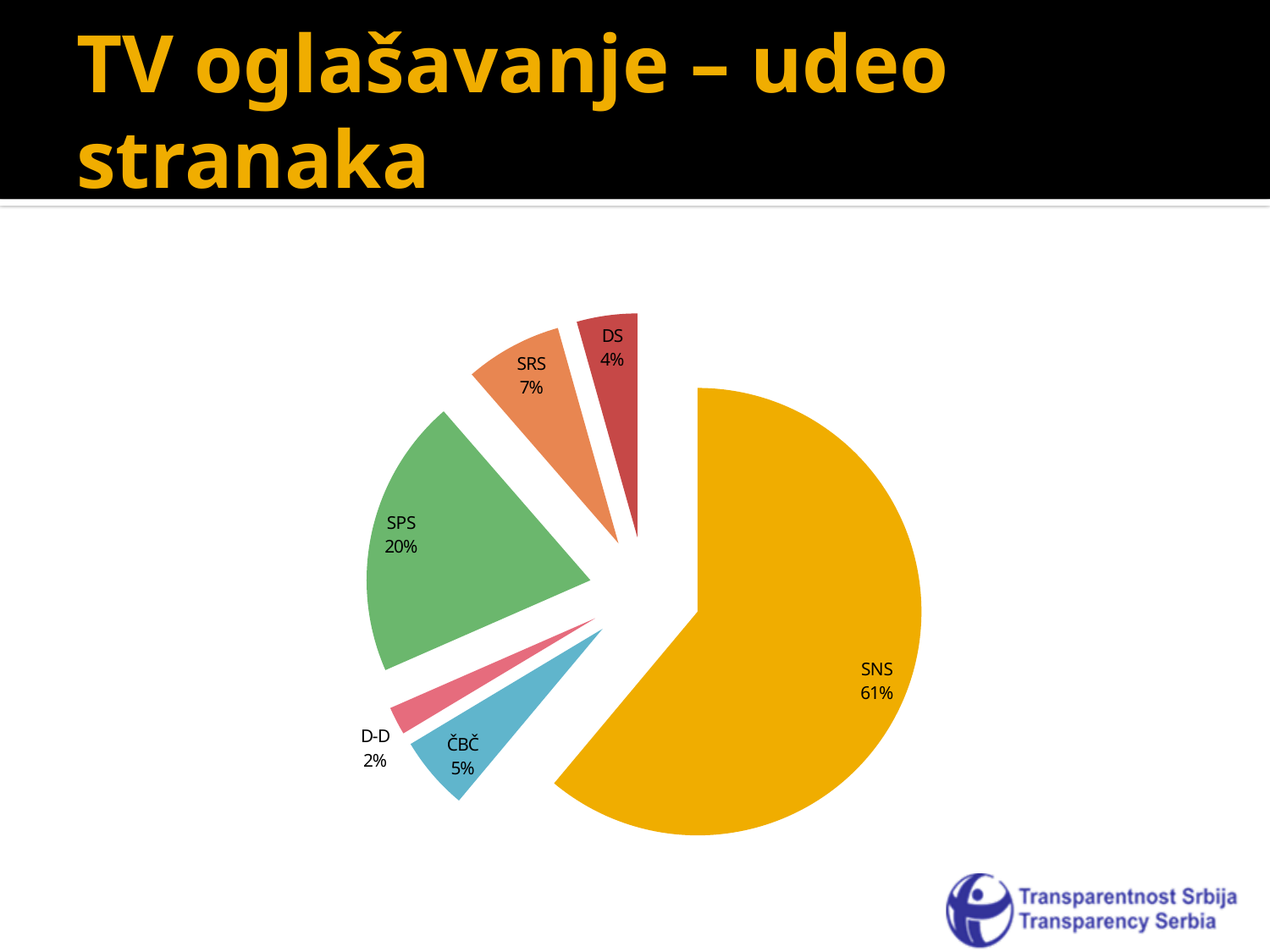
What is the difference in percentage points between SNS and SPS? 41 What percentage is shown for D-D? 2% Which party has the smallest slice of the pie chart? D-D What share does SPS have in the pie chart? 20% What percentage is shown for SRS? 7% What percentage is shown for DS? 4% What percentage is shown for ČBČ? 5% Which has a larger share, SRS or ČBČ? SRS How many slices does the pie chart have? 6 What share of TV advertising does SNS have? 61% What type of chart is shown on the slide? pie chart Which party has the largest slice of the pie chart? SNS